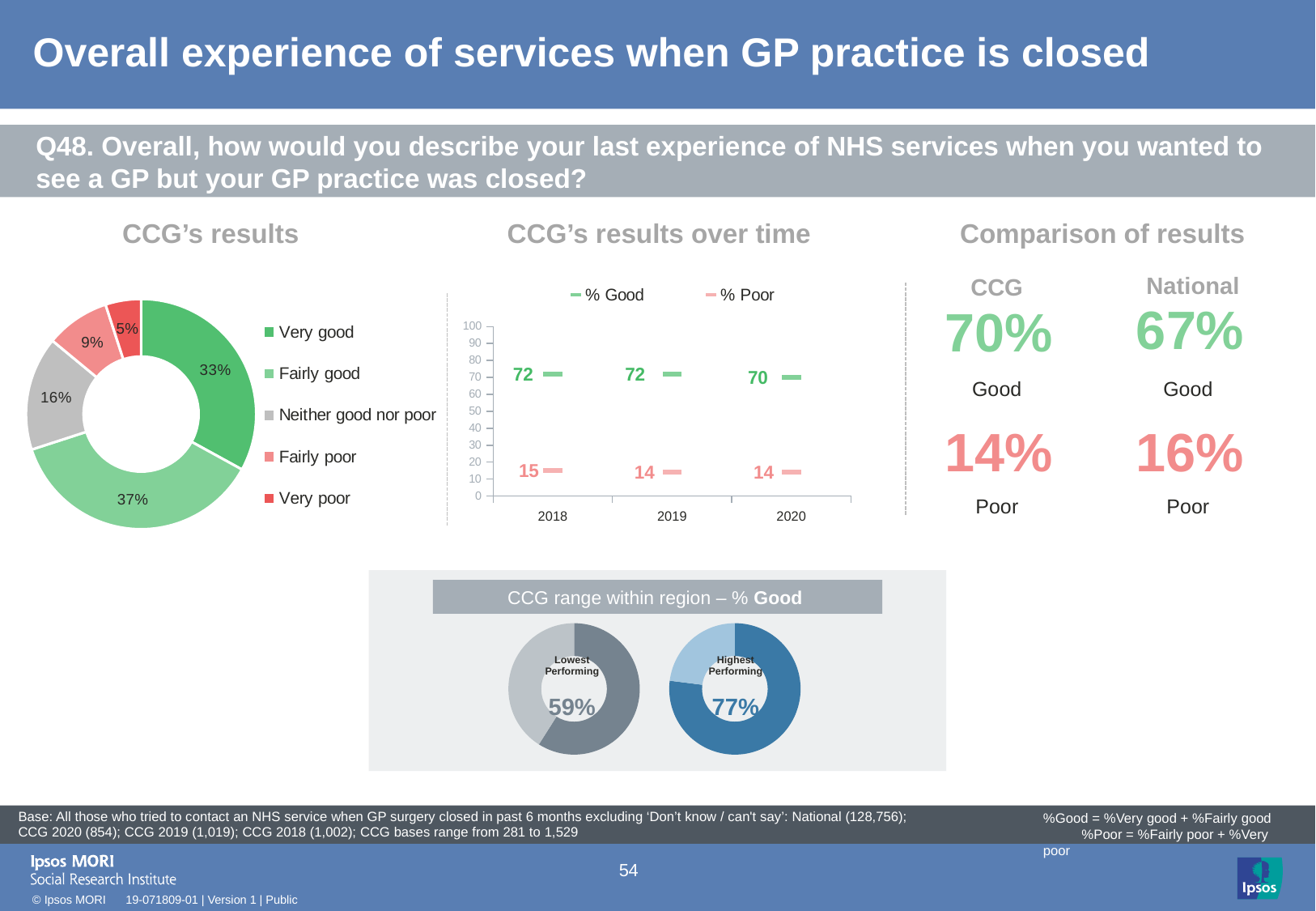
In the 'CCG's results over time' chart, what is the % Poor value for 2018? 15 In the 'CCG range within region – % Good' chart, what is the value for the Highest Performing CCG? 77% In the 'CCG's results over time' chart, what is the % Good value for 2020? 70 In the 'CCG's results' donut chart, how many categories does the legend list? 5 In the 'CCG's results' donut chart, which category has the largest share? Fairly good In the 'CCG's results' donut chart, which category has the smallest share? Very poor In the 'CCG's results over time' chart, is the % Good value for 2018 greater or less than 50? greater In the 'CCG's results' donut chart, what percentage is shown for Very poor? 5% In the 'CCG's results' donut chart, what is the difference in percentage points between Neither good nor poor and Fairly poor? 7 In the 'CCG's results over time' chart, does the % Good value rise or fall from 2019 to 2020? fall In the 'CCG's results' donut chart, what percentage is shown for Fairly good? 37% In the 'CCG's results over time' chart, how many series does the legend list? 2